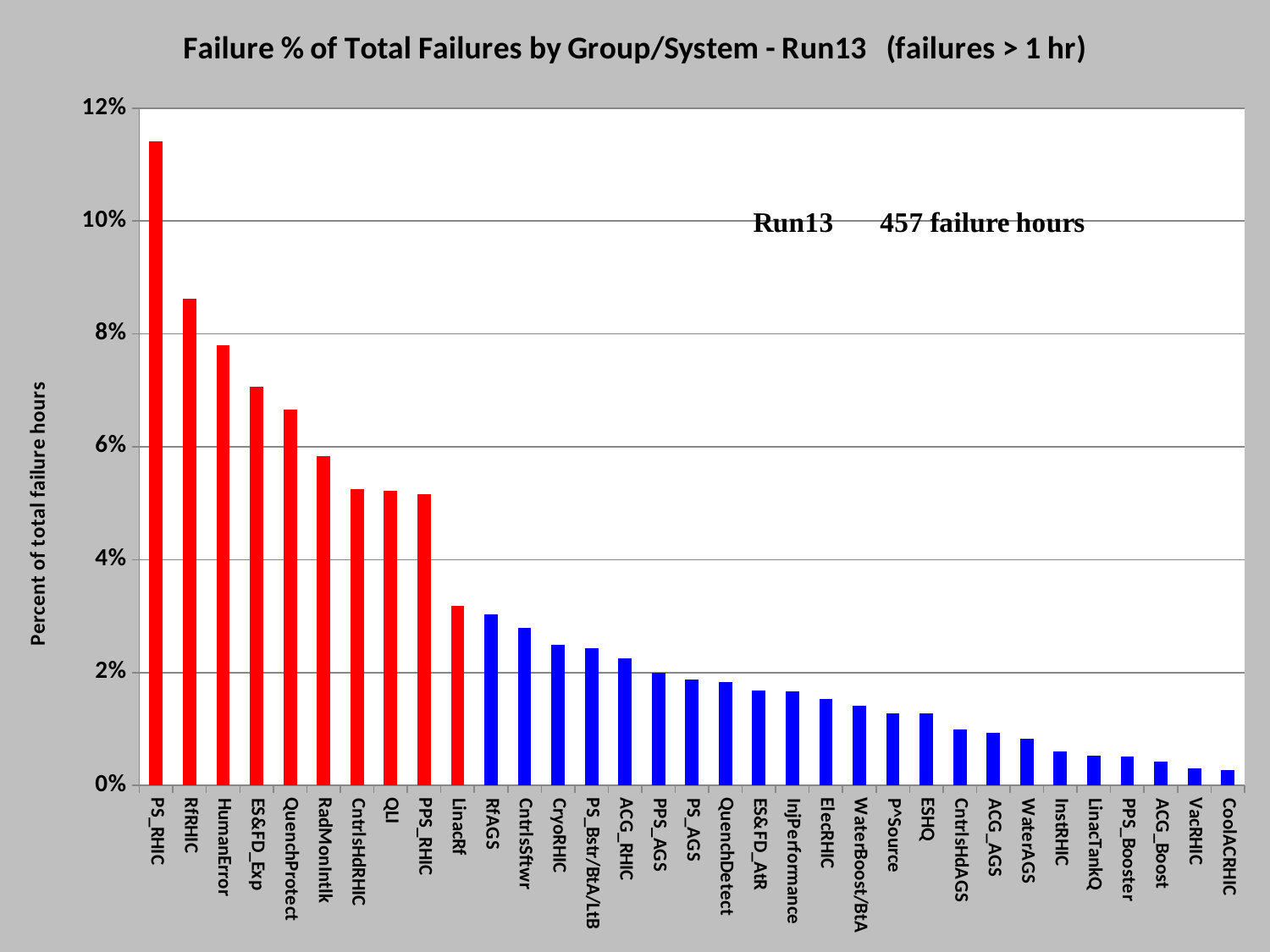
Which group/system has the highest failure percentage? PS_RHIC Is the value for PS_RHIC greater or less than 10%? greater Is the value for HumanError greater or less than 8%? less How many groups/systems are plotted on the chart? 33 What kind of chart is shown on the slide? bar chart Do the values rise or fall moving from left to right along the x axis? fall Is the value for RadMonIntlk greater or less than 6%? less Which has a higher failure percentage, HumanError or QuenchProtect? HumanError How many failure hours does the chart annotation report for Run13? 457 failure hours Which group/system has the lowest failure percentage? CoolACRHIC